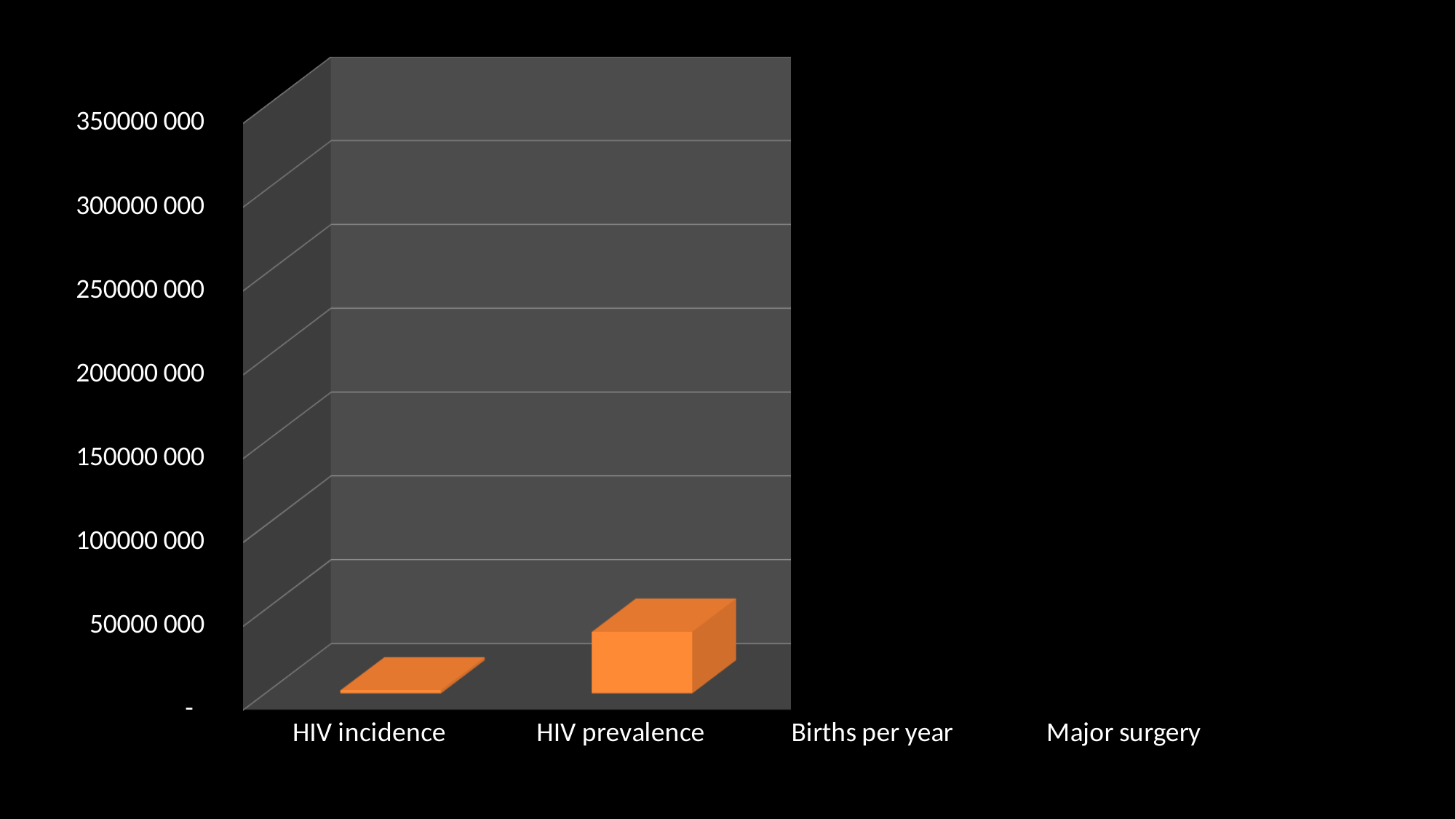
Is the value for HIV incidence greater or less than 50000 000? less What is the label of the first category on the x axis? HIV incidence How many categories are labelled on the x axis of the chart? 4 What is the highest value labelled on the vertical axis of the chart? 350000 000 What kind of chart is shown on the slide? Bar chart Is the value for HIV prevalence greater or less than 100000 000? less Which category has the tallest bar in the chart? HIV prevalence Which of the two visible bars is shorter, HIV incidence or HIV prevalence? HIV incidence Which is larger, the bar for HIV incidence or the bar for HIV prevalence? HIV prevalence What colour are the bars in the chart? Orange